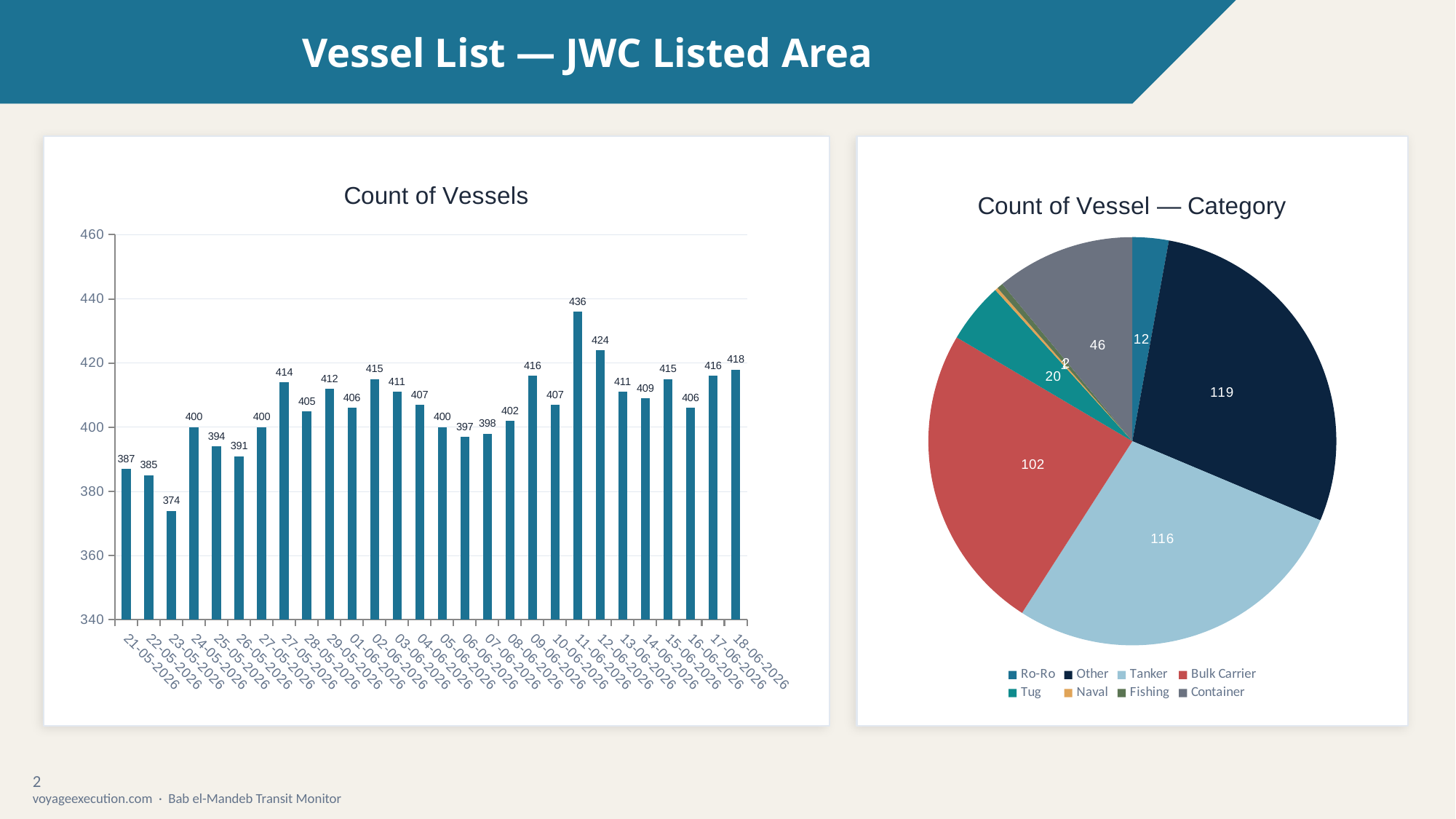
In the Count of Vessel — Category pie chart, which category has the largest slice? Other In the Count of Vessels bar chart, what is the difference between the values for 11-06-2026 and 12-06-2026? 12 What kind of chart is the Count of Vessels chart on the left? Bar chart In the Count of Vessels bar chart, what is the value for 23-05-2026? 374 In the Count of Vessels bar chart, which date has the highest count? 11-06-2026 How many categories does the legend of the Count of Vessel — Category pie chart list? 8 In the Count of Vessel — Category pie chart, what is the value for Tanker? 116 In the Count of Vessels bar chart, which date has the lowest count? 23-05-2026 In the Count of Vessel — Category pie chart, which is larger, Bulk Carrier or Container? Bulk Carrier How many bars are plotted in the Count of Vessels bar chart? 28 In the Count of Vessels bar chart, what is the value for 18-06-2026? 418 In the Count of Vessels bar chart, which is larger, the value for 09-06-2026 or for 10-06-2026? 09-06-2026